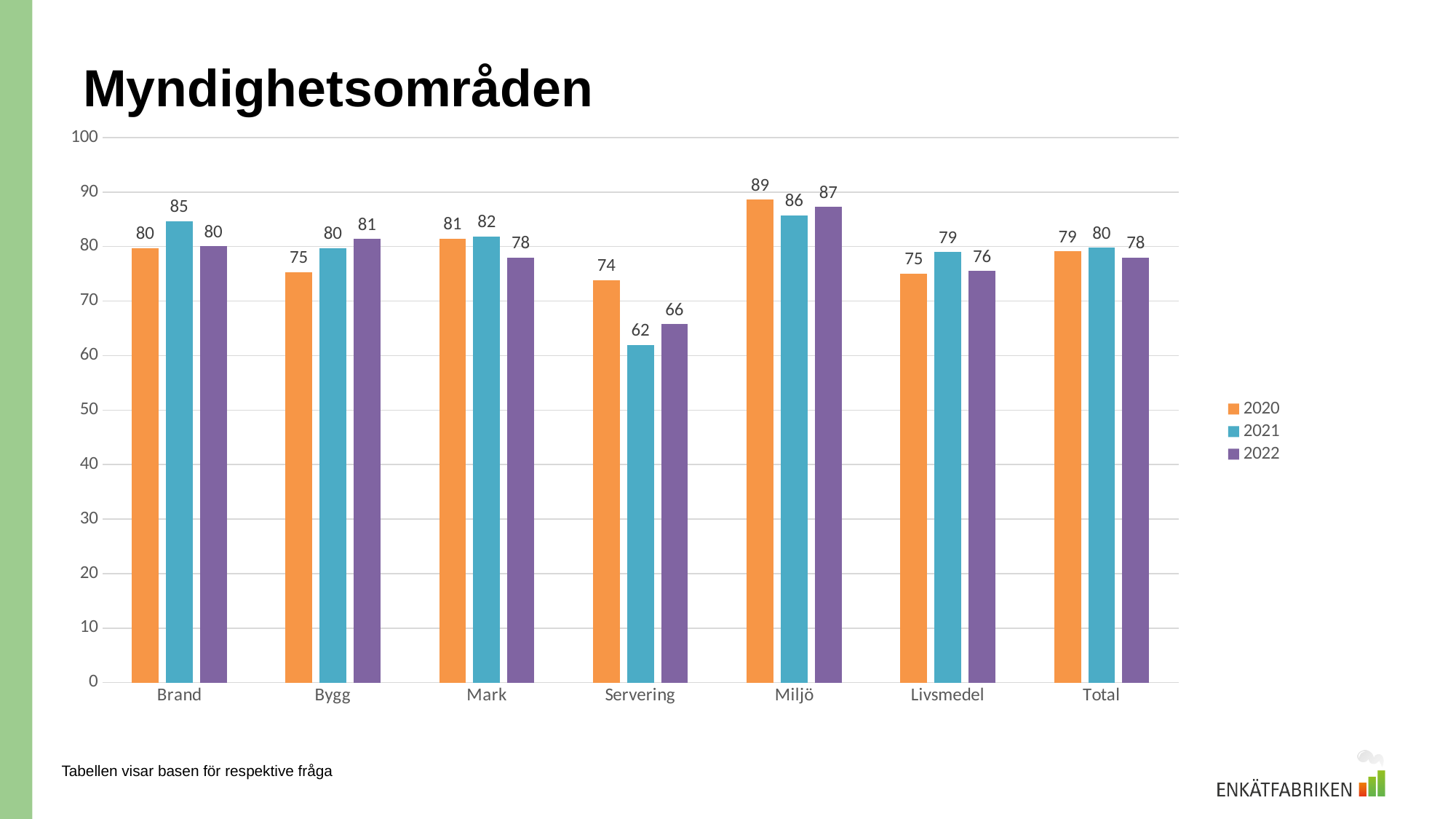
Which is larger for Brand: the 2021 value or the 2022 value? 2021 Which category has the highest value in the 2022 series? Miljö What kind of chart is shown on the slide? Bar chart What is the title of the slide? Myndighetsområden How many series does the legend list? 3 What is the value for Servering in 2021? 62 How many categories are shown on the x axis? 7 What is the value for Miljö in 2020? 89 Which colour represents the 2020 series in the legend? Orange What is the difference between the 2020 and 2021 values for Servering? 12 What is the value for Livsmedel in 2022? 76 Which category has the lowest value in the 2021 series? Servering